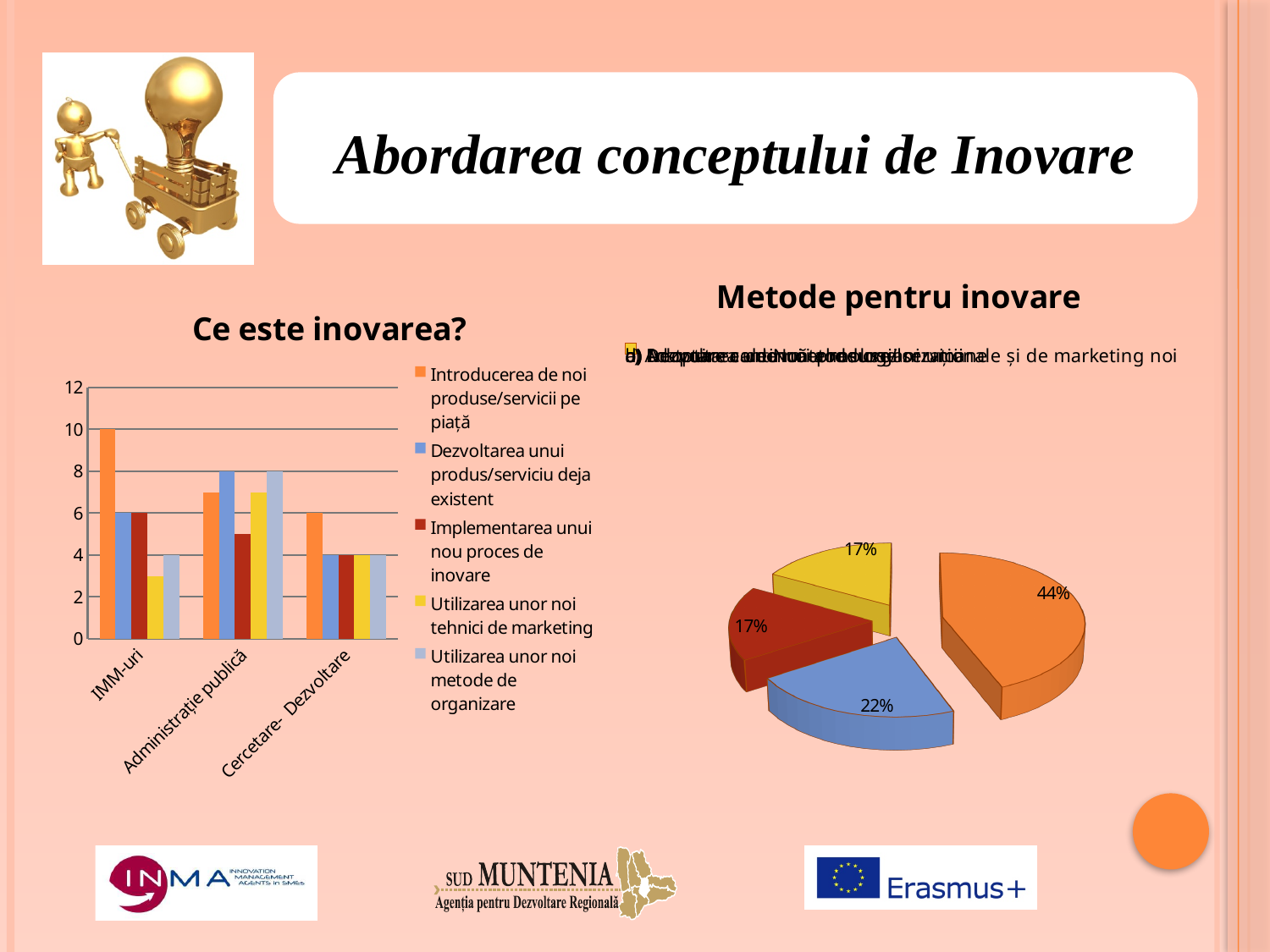
In the bar chart titled "Ce este inovarea?", which category has the highest value for "Introducerea de noi produse/servicii pe piață"? IMM-uri In the bar chart titled "Ce este inovarea?", what is the value of "Introducerea de noi produse/servicii pe piață" for IMM-uri? 10 In the bar chart titled "Ce este inovarea?", what is the value of "Dezvoltarea unui produs/serviciu deja existent" for Administrație publică? 8 In the bar chart titled "Ce este inovarea?", how many categories are shown on the x axis? 3 In the bar chart titled "Ce este inovarea?", which is larger for IMM-uri: "Introducerea de noi produse/servicii pe piață" or "Dezvoltarea unui produs/serviciu deja existent"? Introducerea de noi produse/servicii pe piață In the pie chart under "Metode pentru inovare", what is the share of the blue slice? 22% In the pie chart under "Metode pentru inovare", what is the share of the largest (orange) slice? 44% In the bar chart titled "Ce este inovarea?", what is the value of "Implementarea unui nou proces de inovare" for Cercetare- Dezvoltare? 4 In the bar chart titled "Ce este inovarea?", is the value of "Utilizarea unor noi tehnici de marketing" for IMM-uri greater or less than 4? less In the bar chart titled "Ce este inovarea?", is the value of "Implementarea unui nou proces de inovare" for Administrație publică greater or less than 4? greater What kind of chart is the chart on the right under "Metode pentru inovare"? pie chart In the bar chart titled "Ce este inovarea?", how many series does the legend list? 5